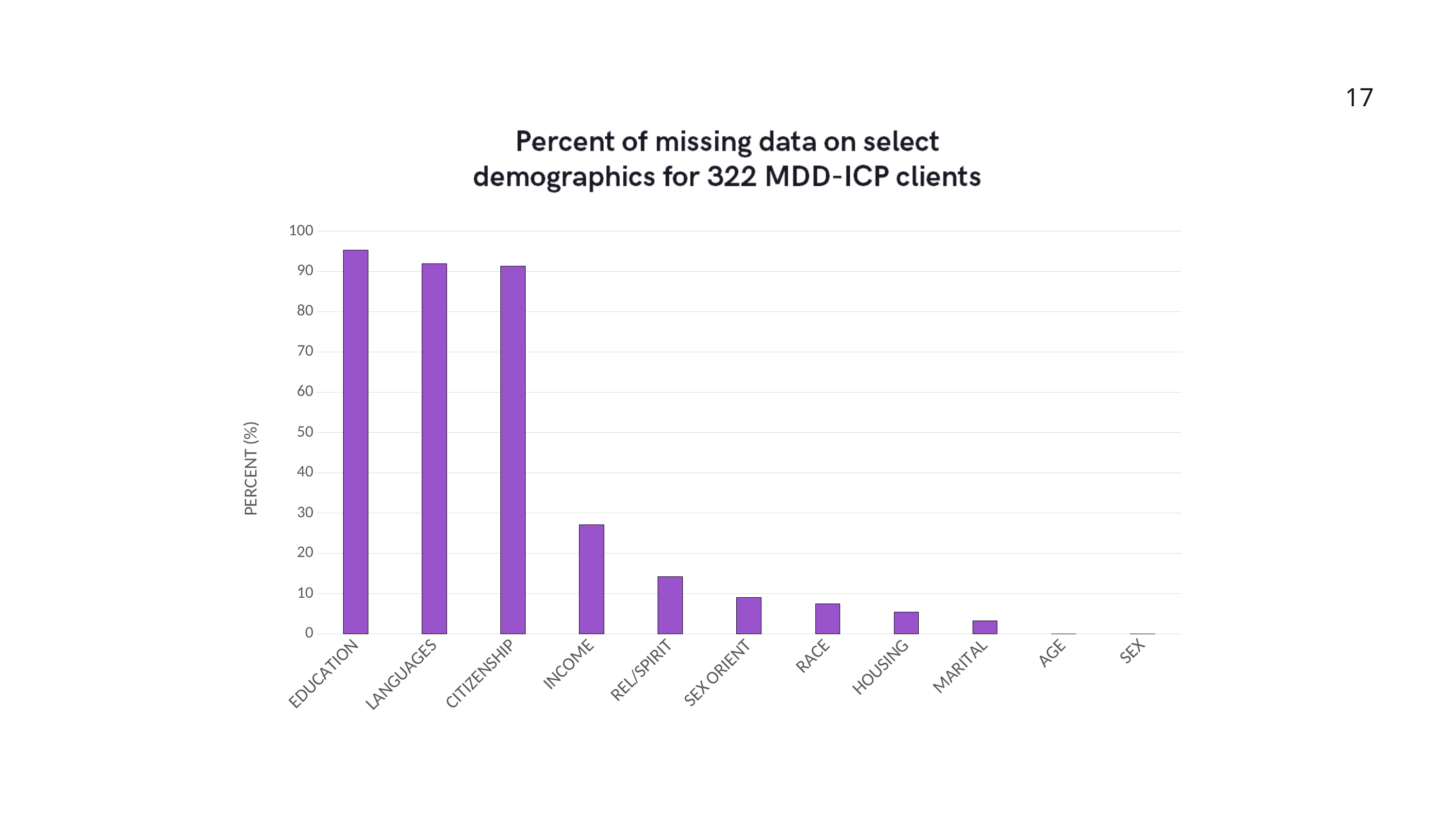
What kind of chart is shown on the slide? bar chart Do the values rise or fall moving from left to right along the x axis? fall What is the title of the chart? Percent of missing data on select demographics for 322 MDD-ICP clients Which category has the highest percent of missing data? EDUCATION Is the value for EDUCATION greater or less than 90? greater Which is larger, the value for CITIZENSHIP or the value for INCOME? CITIZENSHIP Is the value for HOUSING greater or less than 10? less Is the value for INCOME greater or less than 30? less How many categories are shown on the x axis of the chart? 11 What is the label on the y axis of the chart? PERCENT (%)